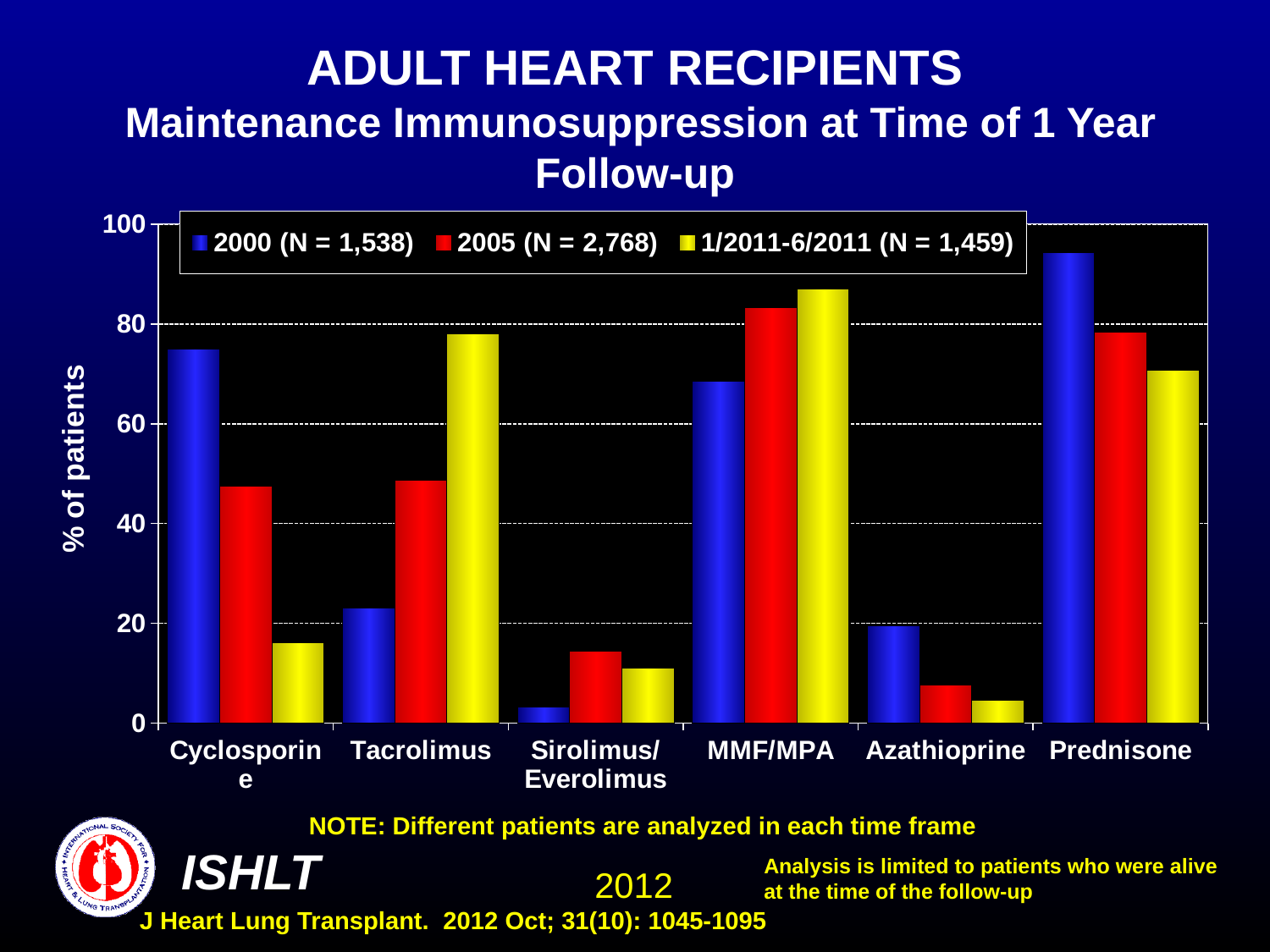
Which is larger for Cyclosporine: the 2000 value or the 1/2011-6/2011 value? 2000 Is the value for Cyclosporine in 2000 greater or less than 60? greater What is the N given in the legend for the 2005 series? N = 2,768 How many series does the legend list? 3 What kind of chart is shown on the slide? Bar chart Does the value for Tacrolimus rise or fall from 2000 to 2005 to 1/2011-6/2011? Rise Is the value for Tacrolimus in 1/2011-6/2011 greater or less than 60? greater Which drug category has the highest value for the 2000 series? Prednisone How many drug categories are shown on the x axis? 6 Is the value for Azathioprine in 1/2011-6/2011 greater or less than 20? less Which is larger in 2005: MMF/MPA or Tacrolimus? MMF/MPA Which drug category has the lowest value for the 2000 series? Sirolimus/Everolimus